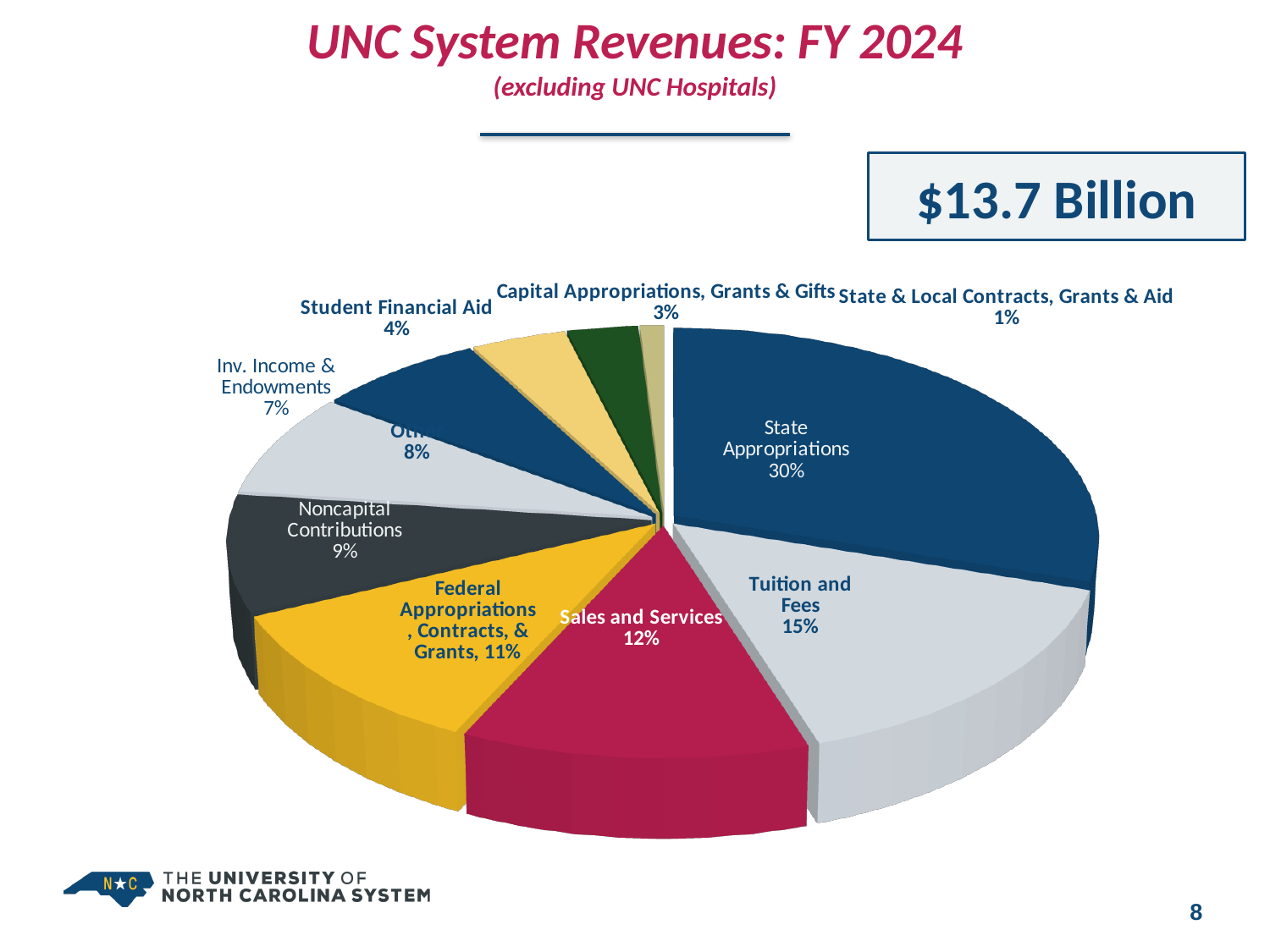
What share of UNC System revenues comes from State Appropriations? 30% What percentage is shown for Federal Appropriations, Contracts, & Grants? 11% What total revenue amount is shown in the box on the slide? $13.7 Billion What percentage of revenues is Tuition and Fees? 15% How many percentage points larger is State Appropriations than Tuition and Fees? 15 Which revenue source has the smallest share of the pie? State & Local Contracts, Grants & Aid Which is larger, Inv. Income & Endowments or Capital Appropriations, Grants & Gifts? Inv. Income & Endowments What percentage is shown for Student Financial Aid? 4% What share of revenues comes from Sales and Services? 12% What share of revenues is Noncapital Contributions? 9% Which revenue source has the largest share of the pie? State Appropriations What kind of chart is shown on the slide? pie chart